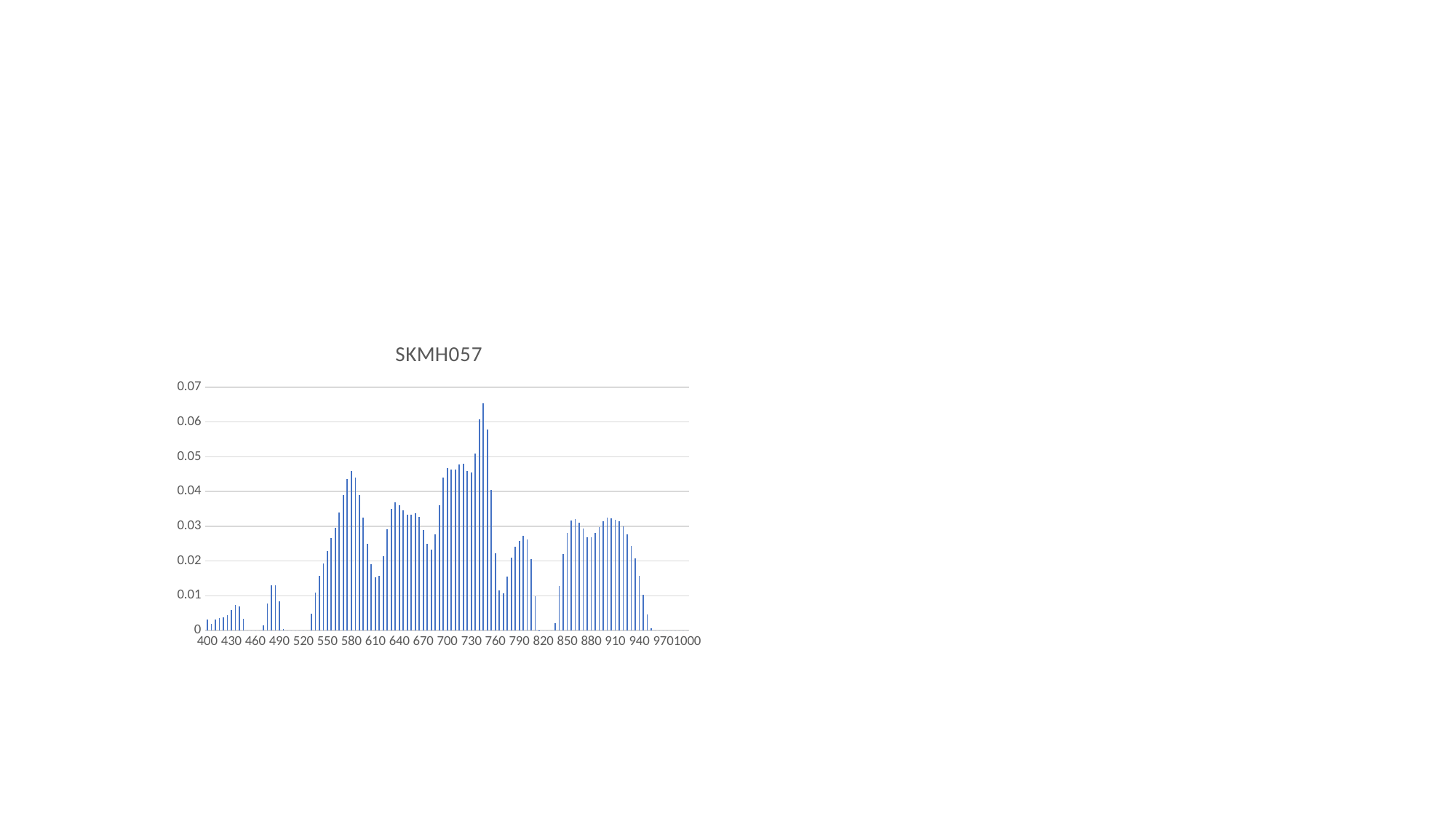
What is the highest value shown on the y axis? 0.07 Is the value for 700 greater or less than 0.04? greater What is the title of the chart? SKMH057 Which is larger, the value for 580 or the value for 430? 580 Is the value for 910 greater or less than 0.02? greater Is the value for 640 greater or less than 0.03? greater What kind of chart is shown on the slide? bar chart How many tick labels are shown on the x axis? 21